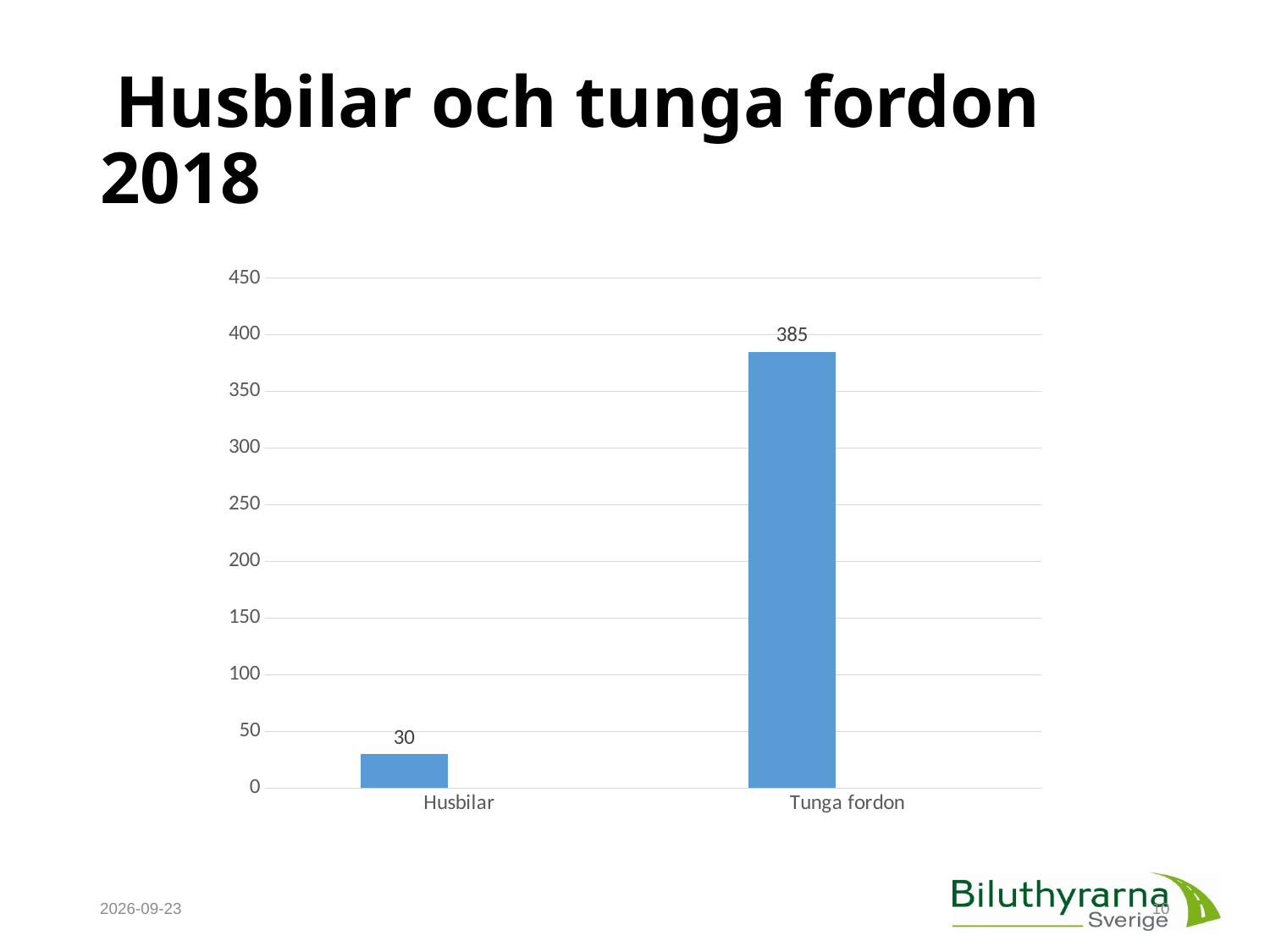
Is the value for Husbilar greater or less than 50? less Which category has the lowest value? Husbilar What is the value for Tunga fordon? 385 What is the title of the slide? Husbilar och tunga fordon 2018 What kind of chart is shown on the slide? bar chart What is the difference between the values for Tunga fordon and Husbilar? 355 How many categories are shown on the x axis? 2 Which is larger, the value for Husbilar or the value for Tunga fordon? Tunga fordon What is the value for Husbilar? 30 Is the value for Tunga fordon greater or less than 400? less What is the highest value shown on the y axis? 450 Which category has the highest value? Tunga fordon